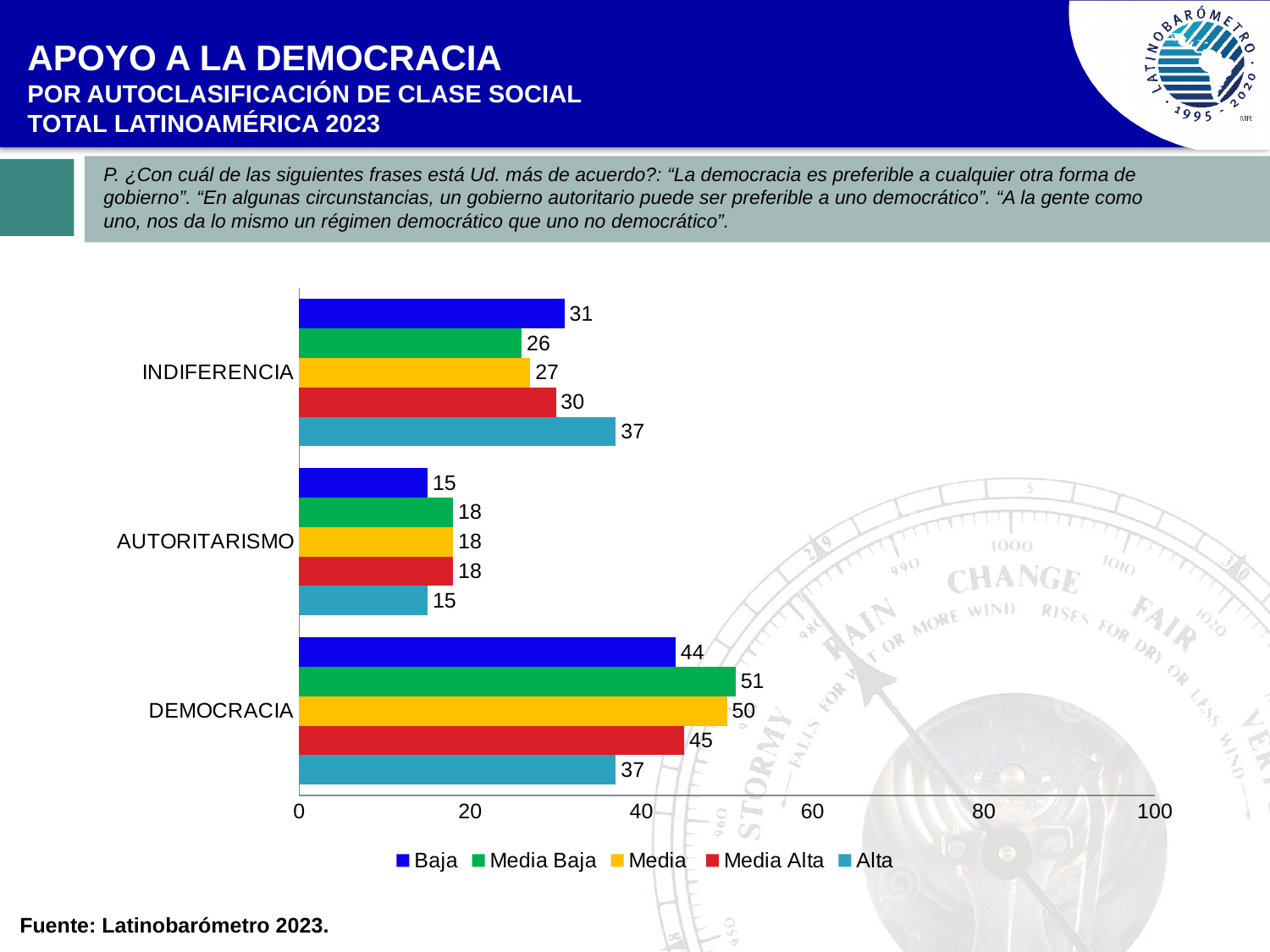
What is the value for Baja in the AUTORITARISMO category? 15 What is the difference between the Media Baja and Alta values in the DEMOCRACIA category? 14 What is the value for Alta in the INDIFERENCIA category? 37 How many series does the legend list? 5 How many categories are shown on the chart? 3 What kind of chart is shown on the slide? Bar chart What is the source cited at the bottom of the slide? Latinobarómetro 2023 Which series has the lowest value in the INDIFERENCIA category? Media Baja What is the difference between the Alta and Baja values in the INDIFERENCIA category? 6 Which series has the highest value in the DEMOCRACIA category? Media Baja What is the value for Media Baja in the DEMOCRACIA category? 51 Which is larger: the Baja value for DEMOCRACIA or the Media Alta value for DEMOCRACIA? Media Alta